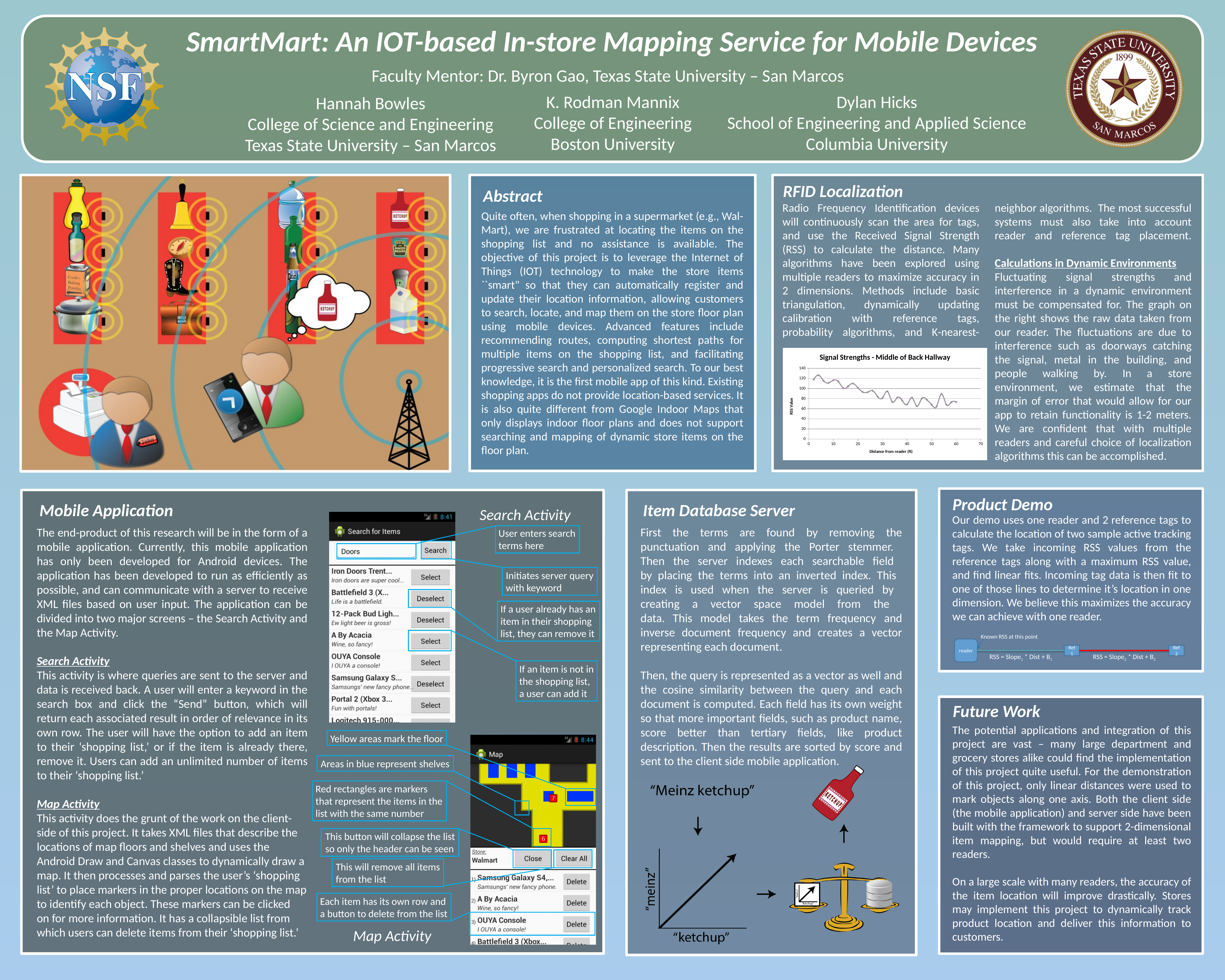
On the Signal Strengths chart, is the RSS value near a distance of 60 ft greater or less than 100? less What kind of chart is shown in the RFID Localization section? line chart On the Signal Strengths chart, do the RSS values generally rise or fall as the distance from the reader increases? fall What is the highest tick value shown on the y axis of the Signal Strengths chart? 140 What is the label of the x axis on the Signal Strengths chart? Distance from reader (ft) On the Signal Strengths chart, is the RSS value at about 5 ft larger or smaller than the RSS value at about 60 ft? larger On the Signal Strengths chart, is the RSS value near a distance of 40 ft greater or less than 40? greater On the Signal Strengths chart, is the RSS value near a distance of 10 ft greater or less than 80? greater What is the title of the chart in the RFID Localization section? Signal Strengths - Middle of Back Hallway